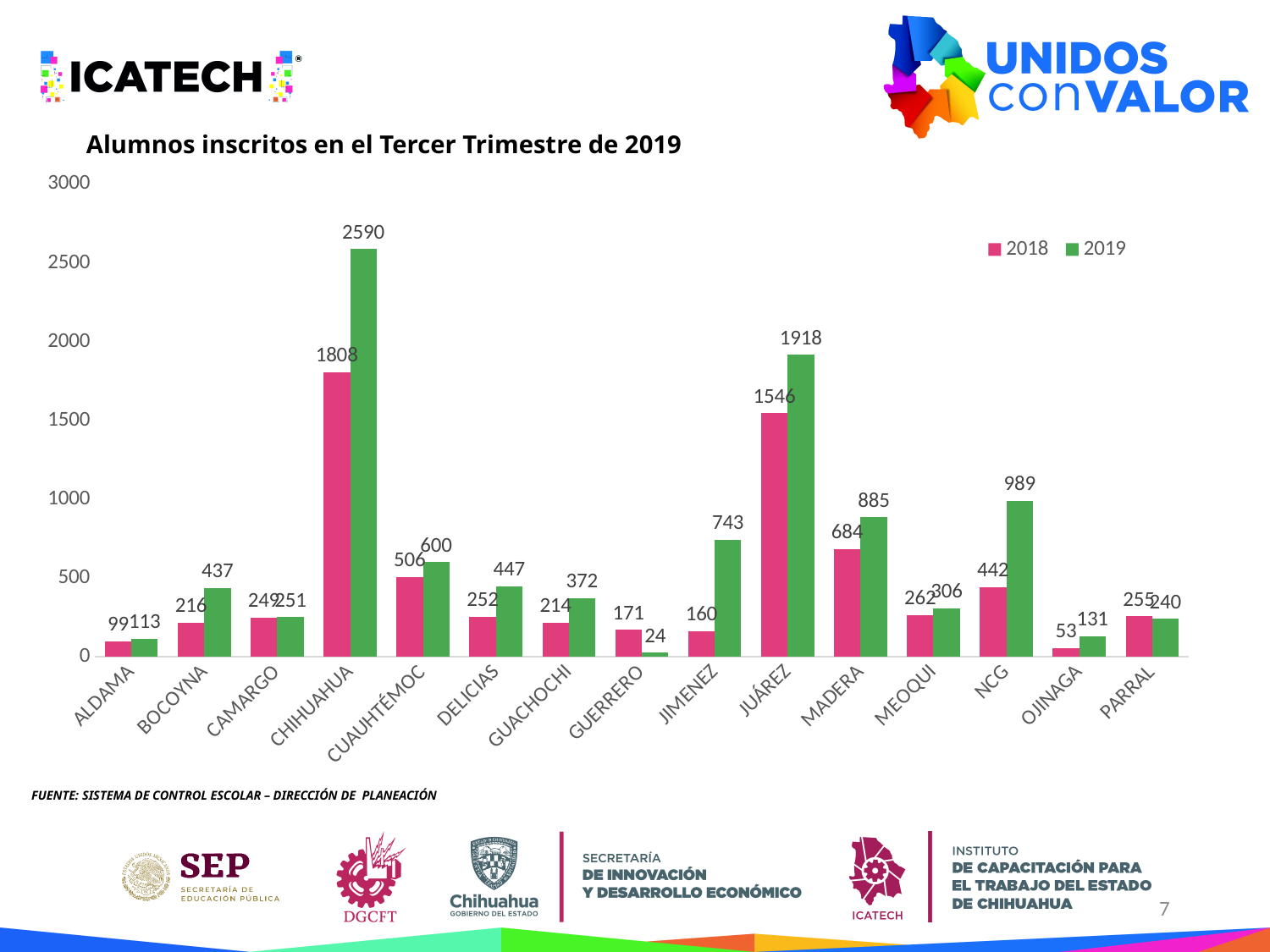
What is the difference between the 2019 and 2018 values for JIMENEZ? 583 Which category has the highest 2019 value? CHIHUAHUA How many categories are shown on the x axis? 15 What is the title of the chart? Alumnos inscritos en el Tercer Trimestre de 2019 What kind of chart is shown on the slide? Bar chart What is the 2019 value for CHIHUAHUA? 2590 What is the 2019 value for NCG? 989 What is the 2018 value for GUERRERO? 171 Which category has the lowest 2019 value? GUERRERO Which is larger for MADERA, the 2018 value or the 2019 value? 2019 What is the 2018 value for JUÁREZ? 1546 How many series does the legend list? 2